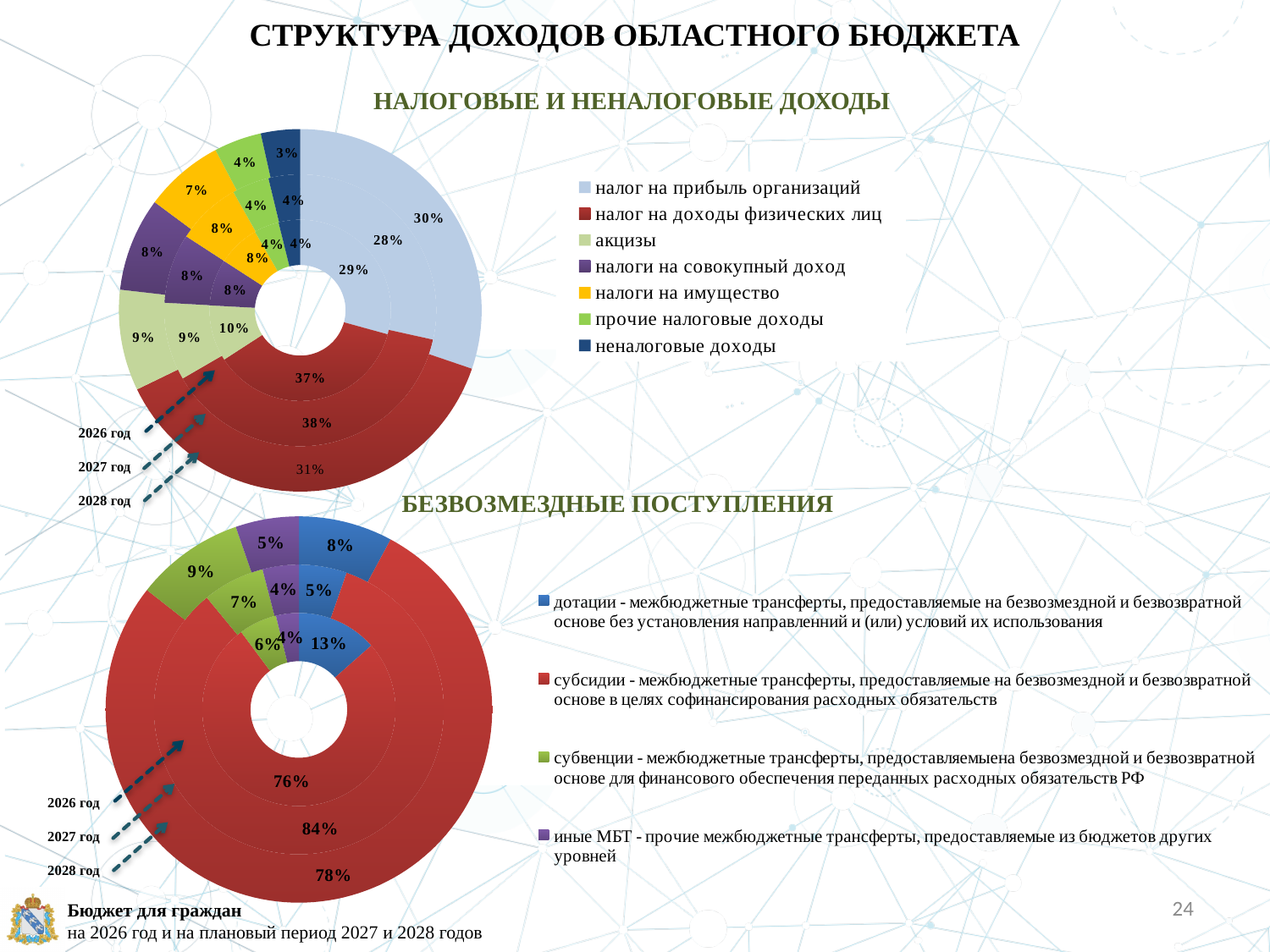
In the 'НАЛОГОВЫЕ И НЕНАЛОГОВЫЕ ДОХОДЫ' chart, what is the share of 'налог на прибыль организаций' in the innermost ring? 29% In the 'БЕЗВОЗМЕЗДНЫЕ ПОСТУПЛЕНИЯ' chart, what is the share of 'субсидии' in the middle ring? 84% In the 'БЕЗВОЗМЕЗДНЫЕ ПОСТУПЛЕНИЯ' chart, which category has the largest share in every ring? субсидии In the 'БЕЗВОЗМЕЗДНЫЕ ПОСТУПЛЕНИЯ' chart, what is the share of 'субсидии' in the outer ring? 78% In the 'НАЛОГОВЫЕ И НЕНАЛОГОВЫЕ ДОХОДЫ' chart, which category has the largest share in the outer ring? налог на доходы физических лиц In the 'НАЛОГОВЫЕ И НЕНАЛОГОВЫЕ ДОХОДЫ' chart, by how many percentage points does 'налог на доходы физических лиц' exceed 'налог на прибыль организаций' in the outer ring? 1 percentage point In the 'БЕЗВОЗМЕЗДНЫЕ ПОСТУПЛЕНИЯ' chart, in the innermost ring, which is larger: 'дотации' or 'субвенции'? дотации In the 'БЕЗВОЗМЕЗДНЫЕ ПОСТУПЛЕНИЯ' chart, how many entries does the legend list? 4 In the 'НАЛОГОВЫЕ И НЕНАЛОГОВЫЕ ДОХОДЫ' chart, which category has the smallest share in the outer ring? неналоговые доходы What kind of chart is used for 'НАЛОГОВЫЕ И НЕНАЛОГОВЫЕ ДОХОДЫ'? Doughnut (pie) chart In the 'НАЛОГОВЫЕ И НЕНАЛОГОВЫЕ ДОХОДЫ' chart, what is the share of 'налог на доходы физических лиц' in the outer ring? 31% In the 'НАЛОГОВЫЕ И НЕНАЛОГОВЫЕ ДОХОДЫ' chart, how many entries does the legend list? 7